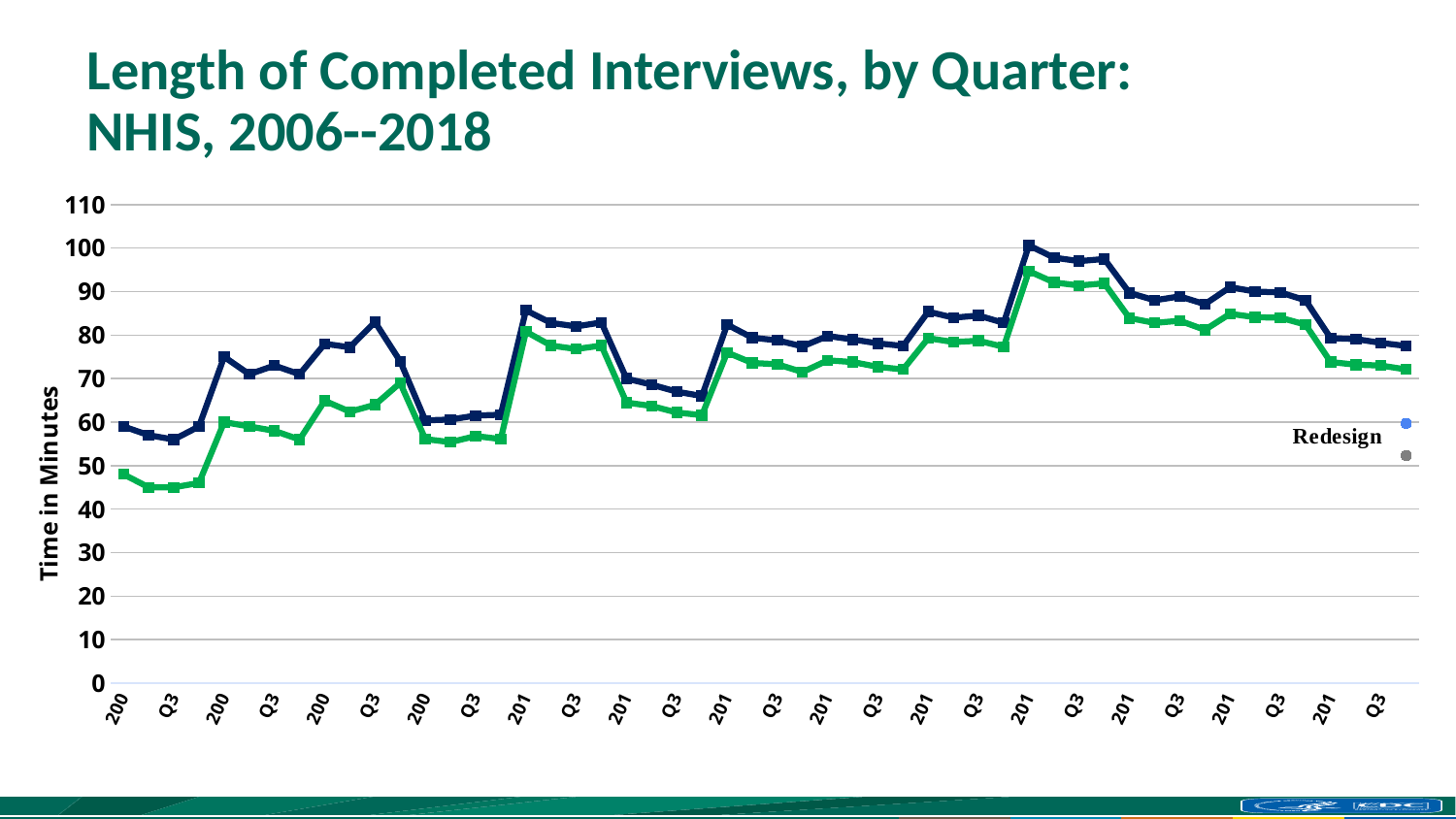
Is the highest point of the green line greater or less than 90 minutes? greater Is the last plotted value of the dark navy line greater or less than 70 minutes? greater Is the lowest point of the dark navy line greater or less than 50 minutes? greater Overall, do the interview lengths rise or fall from the first quarter to the last quarter shown? rise Which line is higher at the first plotted quarter, the dark navy line or the green line? the dark navy line What is the highest value shown on the vertical axis? 110 How many data series (lines) are plotted on the chart? 2 What kind of chart is shown on the slide? line chart What is the label on the vertical axis of the chart? Time in Minutes